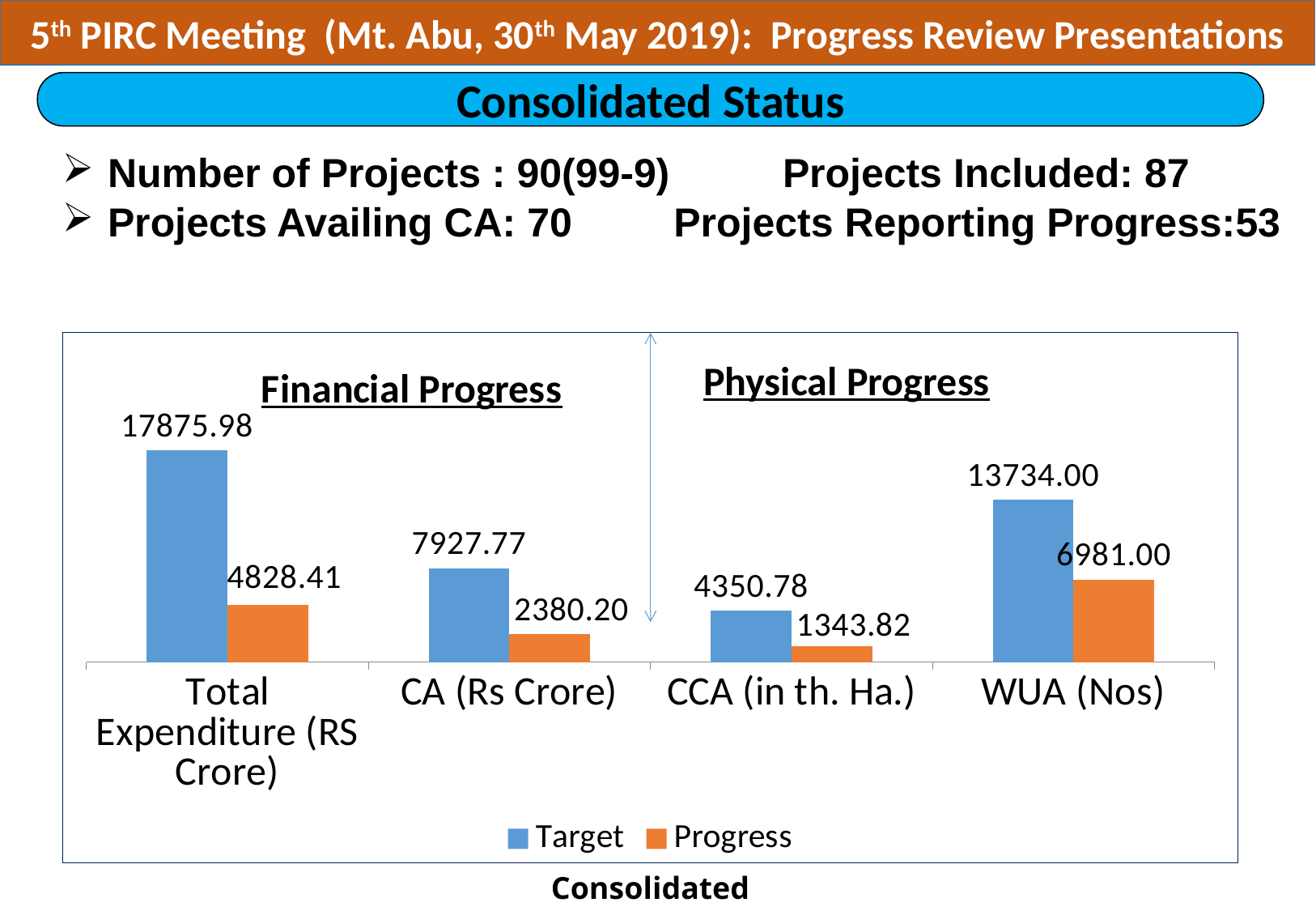
What type of chart is shown on the slide? Bar chart Which is larger: the Progress value for WUA (Nos) or the Target value for CCA (in th. Ha.)? Progress value for WUA (Nos) What is the Target value for CA (Rs Crore)? 7927.77 What is the Progress value for WUA (Nos)? 6981.00 How many categories are shown on the x axis of the chart? 4 Which category has the highest Target value? Total Expenditure (RS Crore) Which category has the lowest Progress value? CCA (in th. Ha.) What is the Progress value for Total Expenditure (RS Crore)? 4828.41 What is the difference between the Target and Progress values for WUA (Nos)? 6753.00 What is the difference between the Target and Progress values for CA (Rs Crore)? 5547.57 How many series does the chart legend list? 2 What is the Target value for CCA (in th. Ha.)? 4350.78